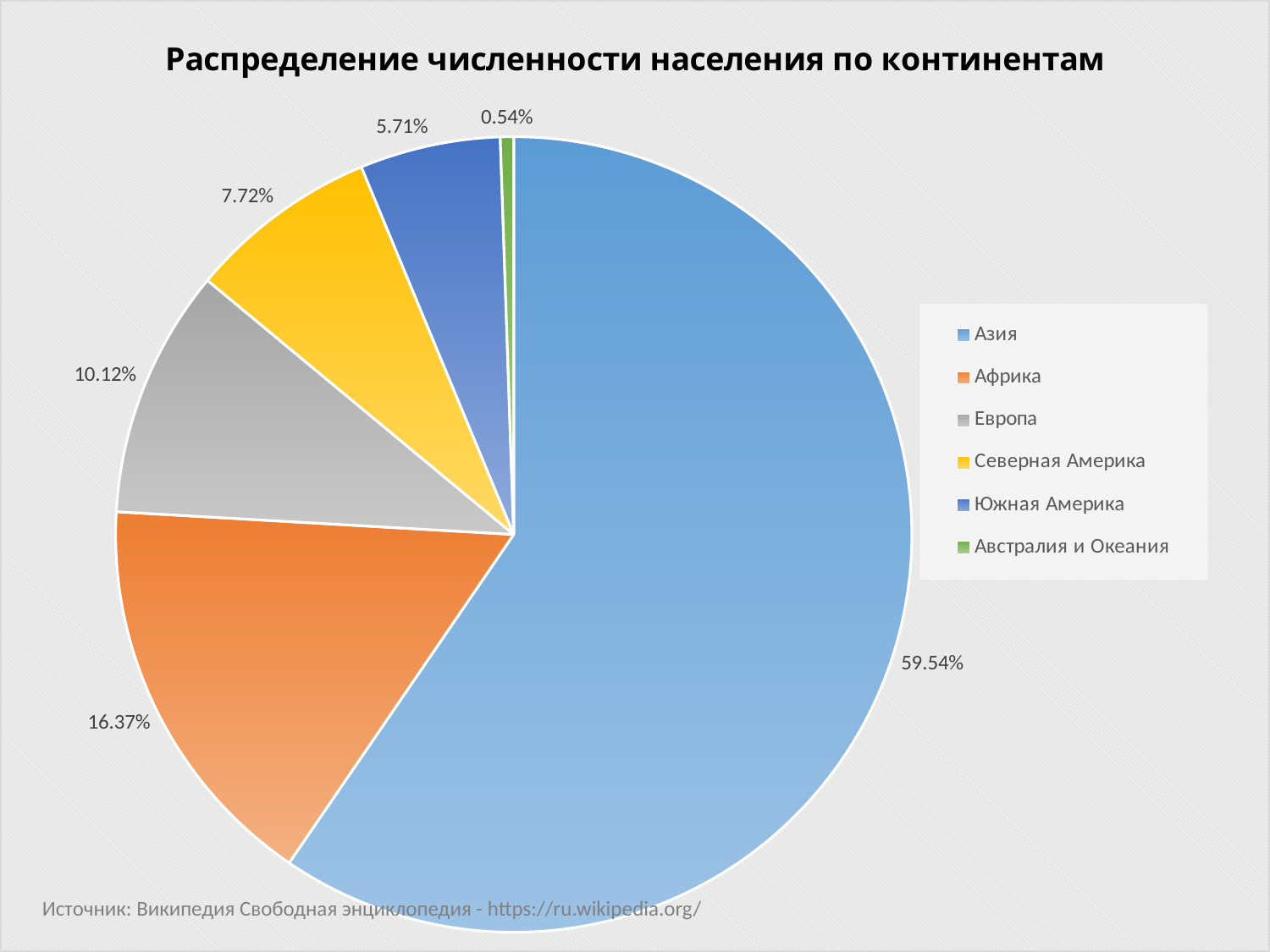
What is the value shown for Европа? 10.12% Which continent has the smallest share of the pie? Австралия и Океания What kind of chart is shown on the slide? Pie chart What is the difference between the shares of Африка and Европа? 6.25% Which continent has the largest share of the pie? Азия What is the value shown for Северная Америка? 7.72% How many slices does the pie chart have? 6 What is the value shown for Африка? 16.37% What is the value shown for Южная Америка? 5.71% What is the value shown for Австралия и Океания? 0.54% What share of the pie does Азия account for? 59.54% Which has a larger share, Северная Америка or Южная Америка? Северная Америка